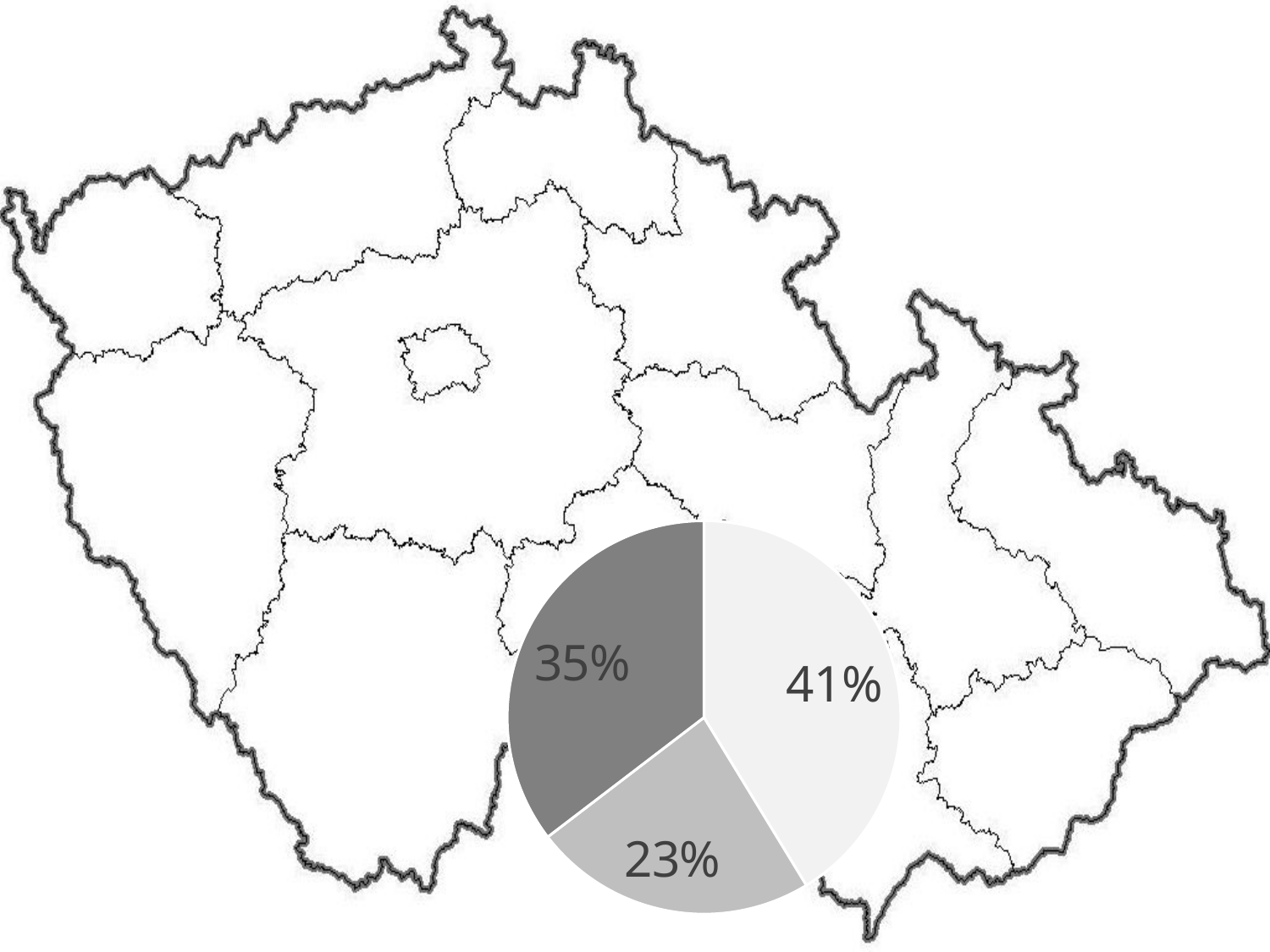
Which slice of the pie chart has the largest share? the lightest slice (41%) What percentage is shown on the darkest slice of the pie chart? 35% Does the pie chart have a legend? No Which is larger, the darkest slice or the medium-grey slice of the pie chart? the darkest slice What is the difference in percentage points between the largest slice and the smallest slice of the pie chart? 18 Which slice of the pie chart has the smallest share? the medium-grey bottom slice (23%) What is drawn behind the pie chart on the slide? a map of the Czech Republic with regional borders How many slices does the pie chart have? 3 What percentage is shown on the lightest slice of the pie chart? 41% What kind of chart is shown on the slide? pie chart What is the difference in percentage points between the 41% slice and the 35% slice? 6 What percentage is shown on the medium-grey slice at the bottom of the pie chart? 23%